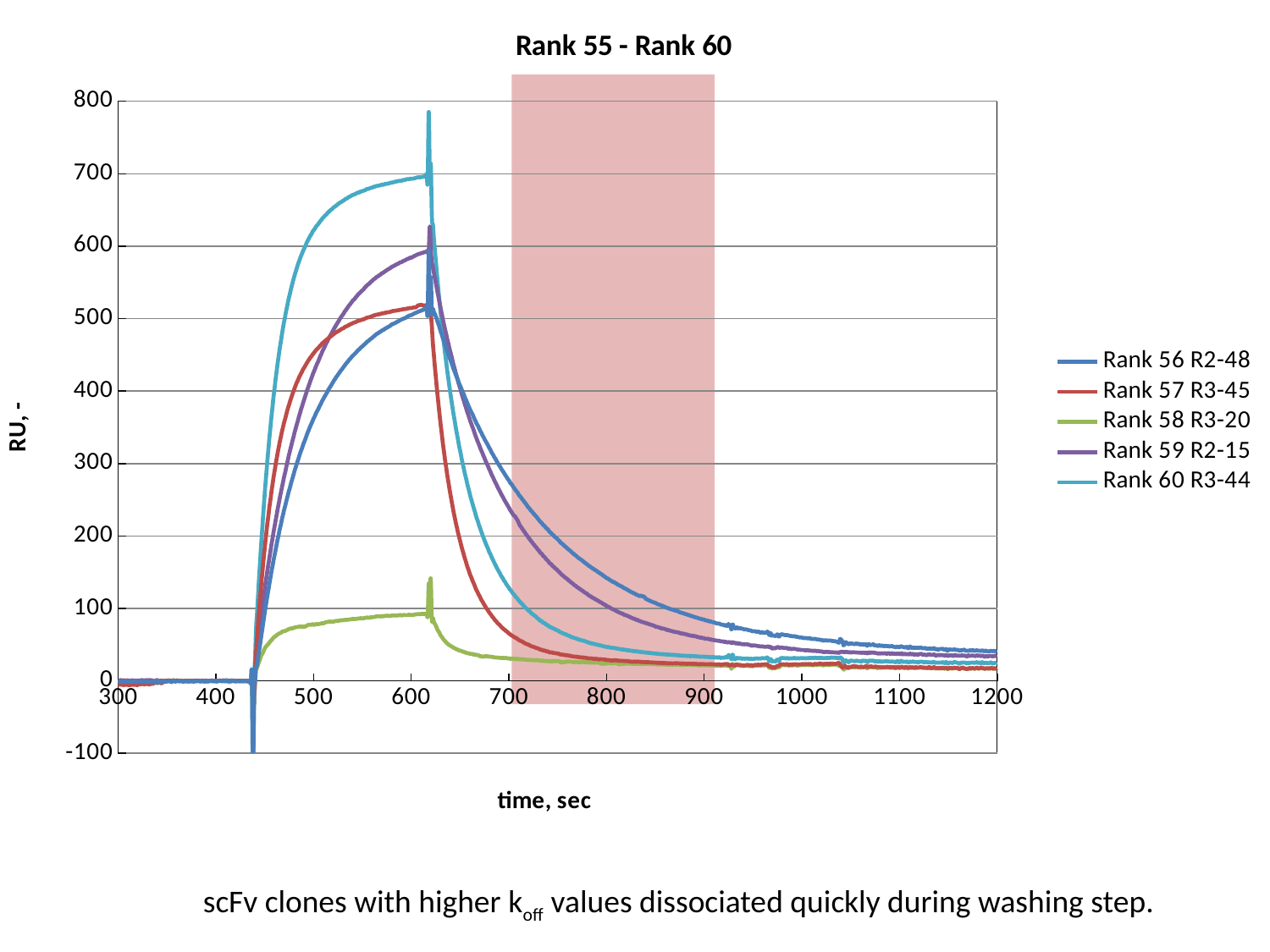
Is the value for Rank 57 R3-45 at 700 sec greater or less than 100? less What is the label of the x axis? time, sec Which series reaches the highest RU value on the chart? Rank 60 R3-44 Between 700 and 900 sec, do the values of the series rise or fall? fall At 600 sec, which series has the higher value, Rank 59 R2-15 or Rank 57 R3-45? Rank 59 R2-15 What kind of chart is shown on the slide? line chart What is the title of the chart? Rank 55 - Rank 60 How many series does the legend list? 5 Is the value for Rank 56 R2-48 at 800 sec greater or less than 200? less Which series stays lowest during the binding phase between 500 and 600 sec? Rank 58 R3-20 Is the value for Rank 60 R3-44 at 600 sec greater or less than 600? greater